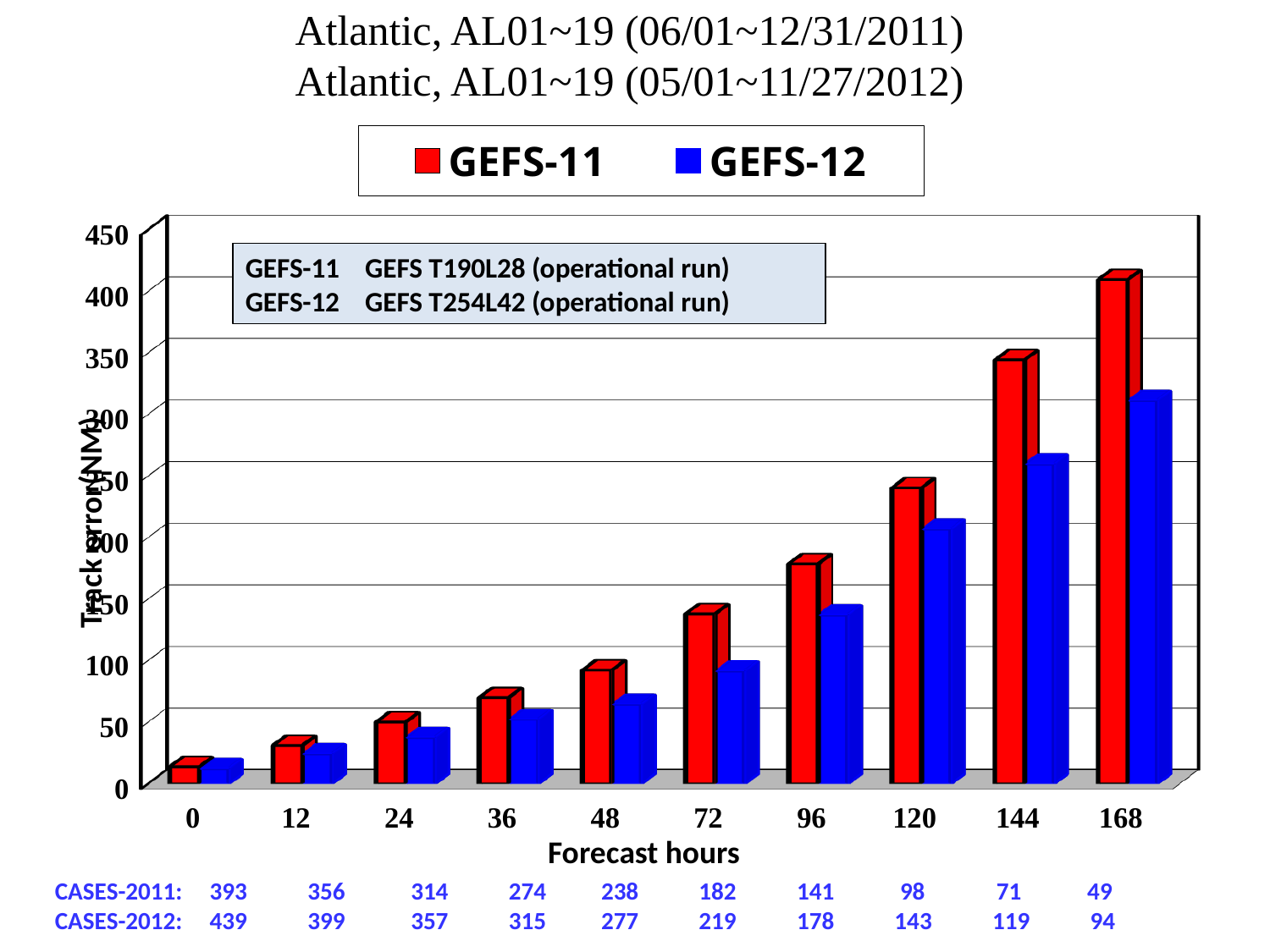
At 168 forecast hours, which series has the larger track error, GEFS-11 or GEFS-12? GEFS-11 At which forecast hour is the GEFS-12 track error lowest? 0 How many series does the legend list? 2 What is the label of the x axis? Forecast hours How many forecast-hour categories are plotted along the x axis? 10 At which forecast hour is the GEFS-11 track error highest? 168 Is the GEFS-12 track error at 120 forecast hours greater or less than 250? less What kind of chart is shown on the slide? bar chart Is the GEFS-12 track error at 168 forecast hours greater or less than 250? greater Is the GEFS-11 track error at 96 forecast hours greater or less than 150? greater Do the track error values rise or fall as forecast hours increase? rise